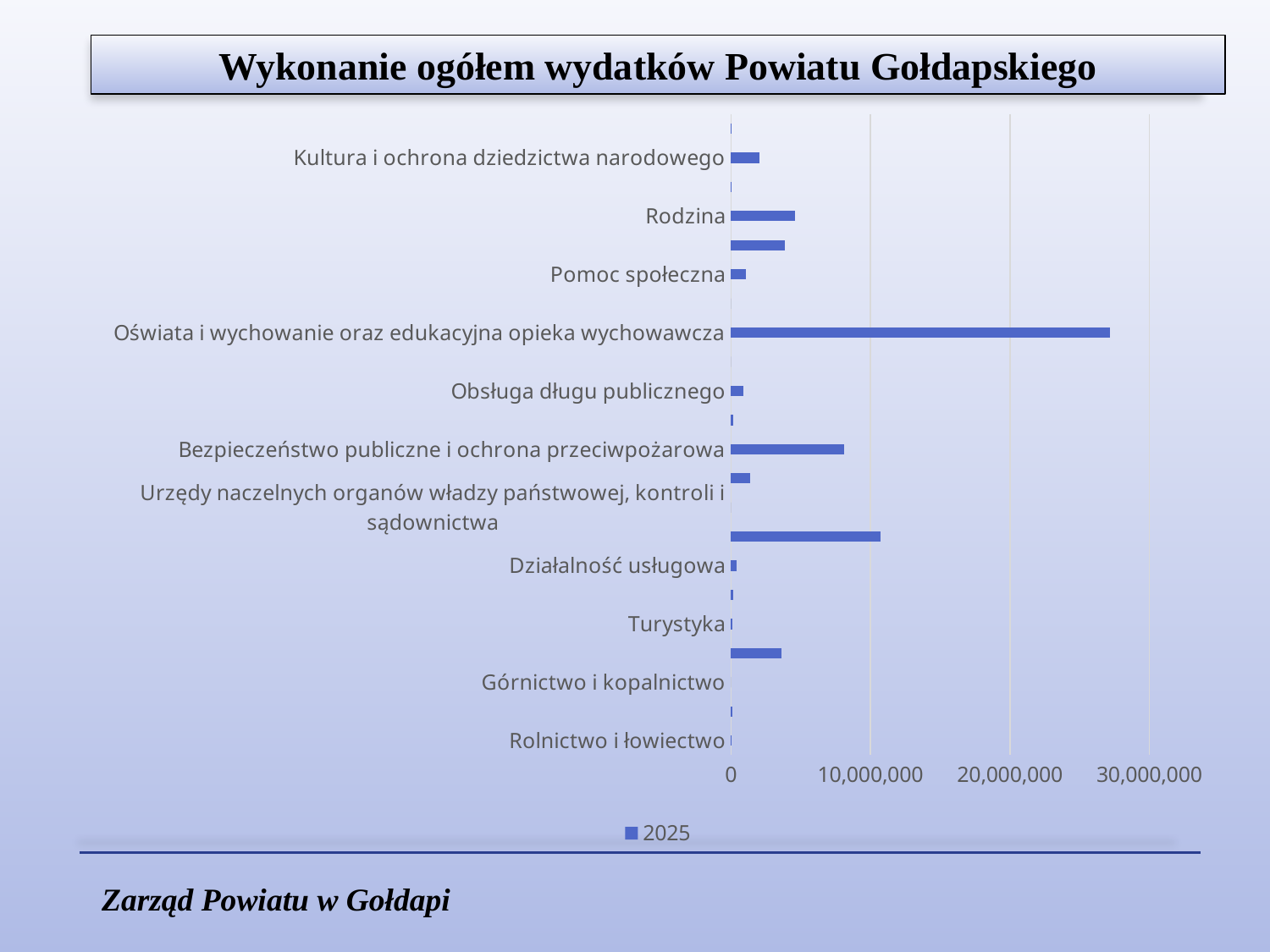
Is the value for Rodzina greater or less than 10,000,000? less Which is larger, the value for Bezpieczeństwo publiczne i ochrona przeciwpożarowa or the value for Obsługa długu publicznego? Bezpieczeństwo publiczne i ochrona przeciwpożarowa Is the value for Bezpieczeństwo publiczne i ochrona przeciwpożarowa greater or less than 10,000,000? less Is the value for Oświata i wychowanie oraz edukacyjna opieka wychowawcza greater or less than 20,000,000? greater Which is larger, the value for Rodzina or the value for Pomoc społeczna? Rodzina Which category has the highest value? Oświata i wychowanie oraz edukacyjna opieka wychowawcza How many series does the legend list? 1 What kind of chart is shown on the slide? bar chart Which is larger, the value for Oświata i wychowanie oraz edukacyjna opieka wychowawcza or the value for Bezpieczeństwo publiczne i ochrona przeciwpożarowa? Oświata i wychowanie oraz edukacyjna opieka wychowawcza What is the legend entry of the chart? 2025 What is the title of the chart? Wykonanie ogółem wydatków Powiatu Gołdapskiego